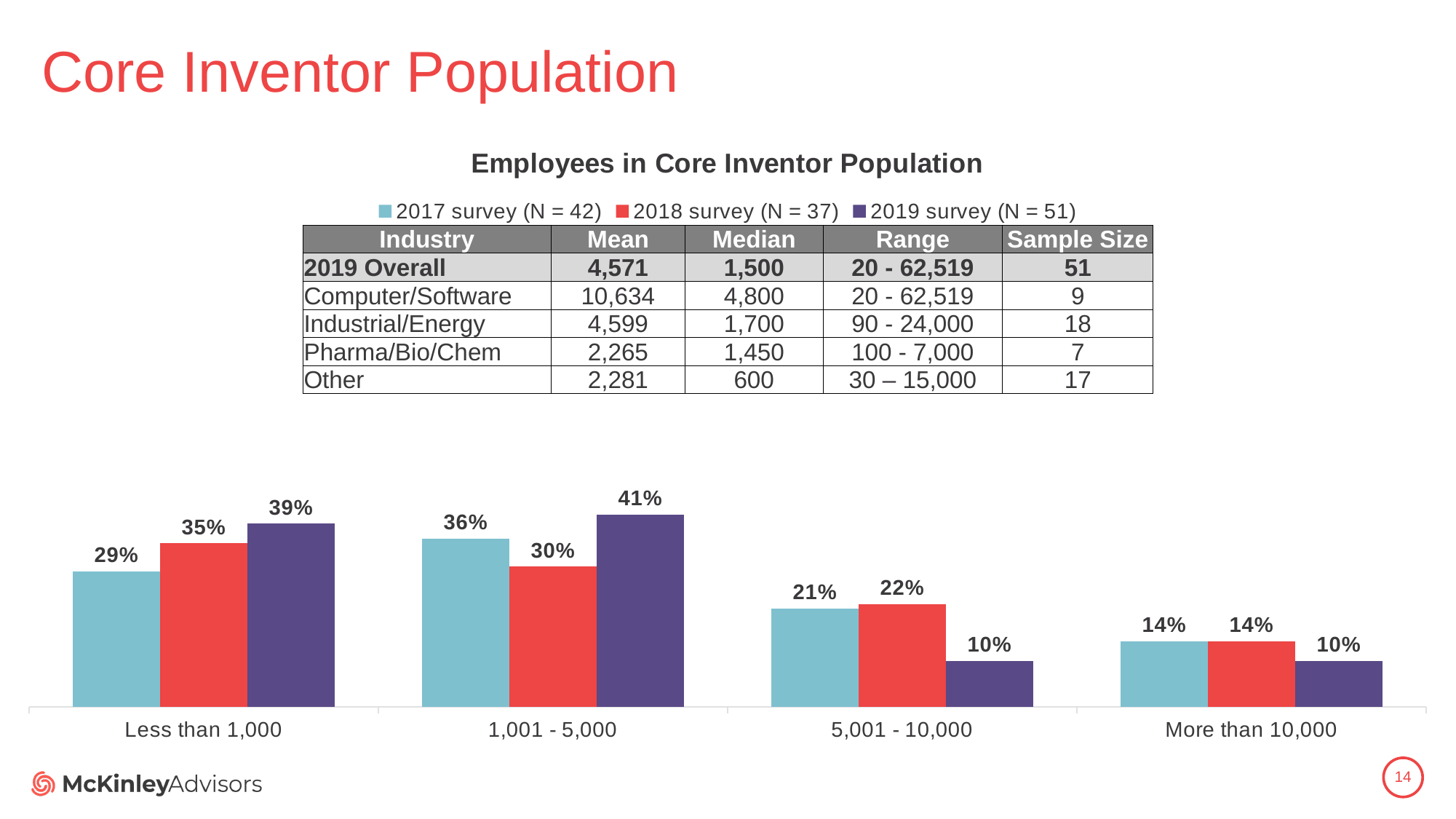
Which category has the lowest value for the 2017 survey? More than 10,000 What is the value for the 2017 survey in the '5,001 - 10,000' category? 21% What is the difference between the 2019 survey and 2017 survey values in the 'Less than 1,000' category? 10% How many series does the chart legend list? 3 Do the 2018 survey values rise or fall from '1,001 - 5,000' to 'More than 10,000'? Fall What is the value for the 2019 survey in the 'Less than 1,000' category? 39% What kind of chart is shown on the slide? Bar chart Which category has the highest value for the 2019 survey? 1,001 - 5,000 What is the value for the 2018 survey in the '1,001 - 5,000' category? 30% How many categories are shown on the x axis of the chart? 4 What is the title of the chart? Employees in Core Inventor Population Which is larger in the '1,001 - 5,000' category: the 2017 survey value or the 2018 survey value? 2017 survey